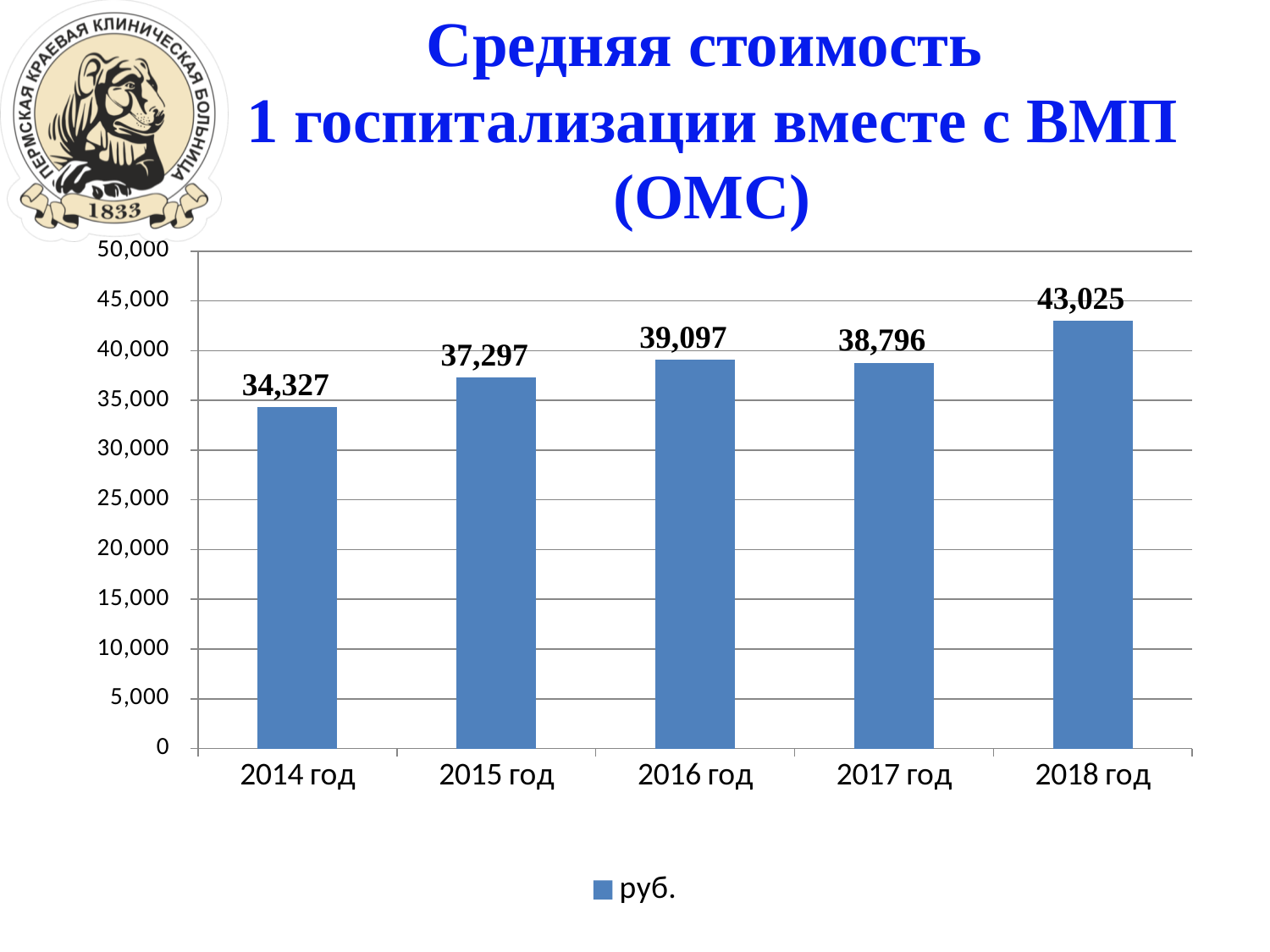
What is the value for 2018 год? 43,025 What kind of chart is shown on the slide? bar chart What is the value for 2014 год? 34,327 Which is larger, the value for 2016 год or 2017 год? 2016 год What is the difference between the values for 2018 год and 2014 год? 8,698 How many years are shown on the x axis? 5 What is the difference between the values for 2016 год and 2015 год? 1,800 Which year has the highest value? 2018 год What is the value for 2017 год? 38,796 Which year has the lowest value? 2014 год What is the legend entry for the series? руб. Is the value for 2015 год greater or less than 35,000? greater